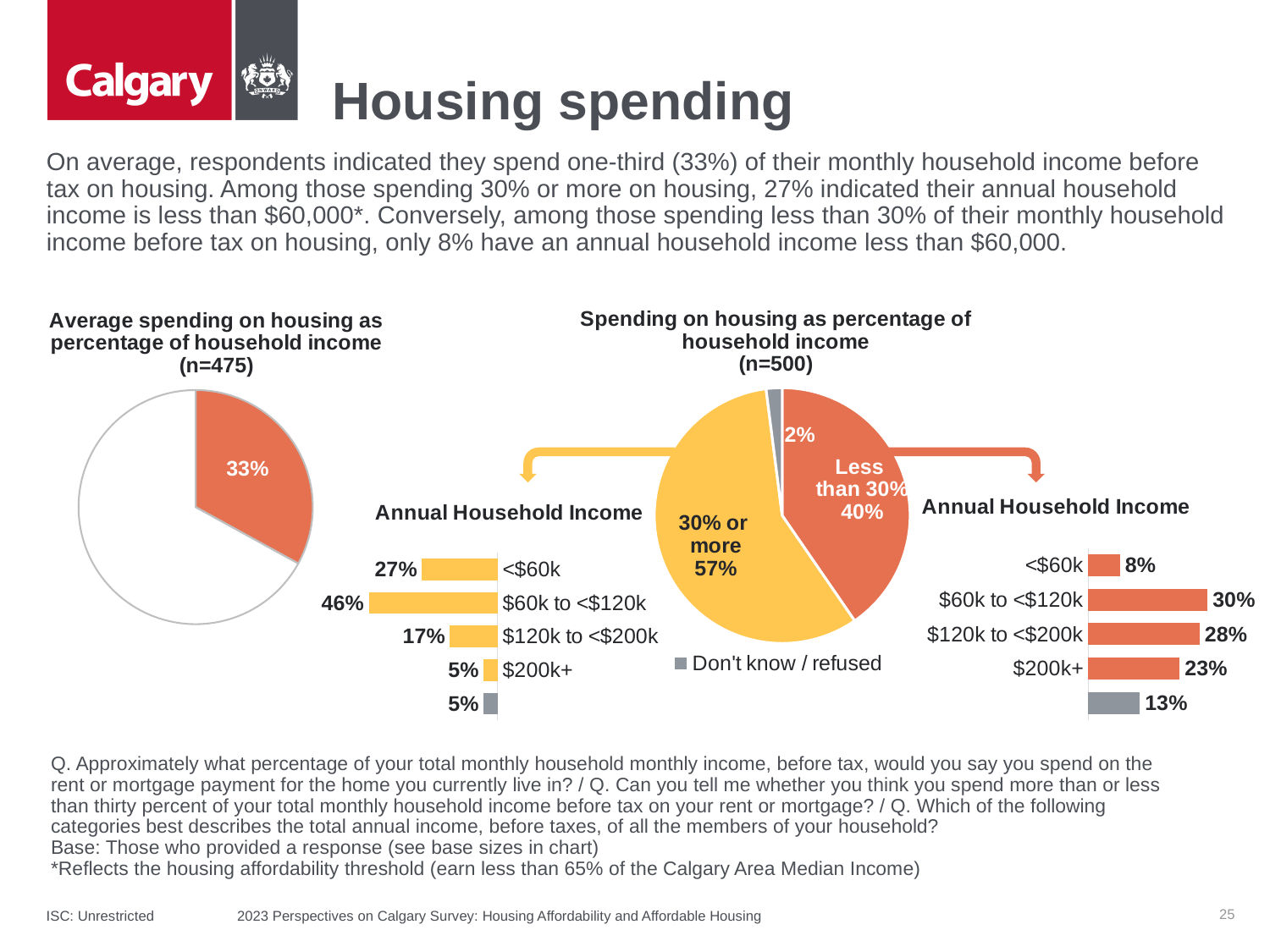
What type of chart is used to show "Spending on housing as percentage of household income (n=500)"? Pie chart In the pie chart titled "Spending on housing as percentage of household income (n=500)", what share of respondents spend 30% or more? 57% In the pie chart titled "Average spending on housing as percentage of household income (n=475)", what value is shown for the highlighted slice? 33% In the right "Annual Household Income" bar chart (for those spending less than 30%), what is the value for "$200k+"? 23% What type of chart is used to show "Annual Household Income" on the right side of the slide? Bar chart In the right "Annual Household Income" bar chart (for those spending less than 30%), which labelled income category has the lowest value? <$60k In the pie chart titled "Spending on housing as percentage of household income (n=500)", what share is "Don't know / refused"? 2% In the left "Annual Household Income" bar chart (for those spending 30% or more), which income category has the highest value? $60k to <$120k In the left "Annual Household Income" bar chart (for those spending 30% or more), what is the value for "<$60k"? 27% In the pie chart titled "Spending on housing as percentage of household income (n=500)", what share of respondents spend less than 30%? 40% Which is larger: the "$120k to <$200k" value in the left "Annual Household Income" bar chart or in the right "Annual Household Income" bar chart? The right chart (28% vs 17%) What is the difference between the "<$60k" value in the left "Annual Household Income" bar chart (27%) and the "<$60k" value in the right "Annual Household Income" bar chart (8%)? 19 percentage points